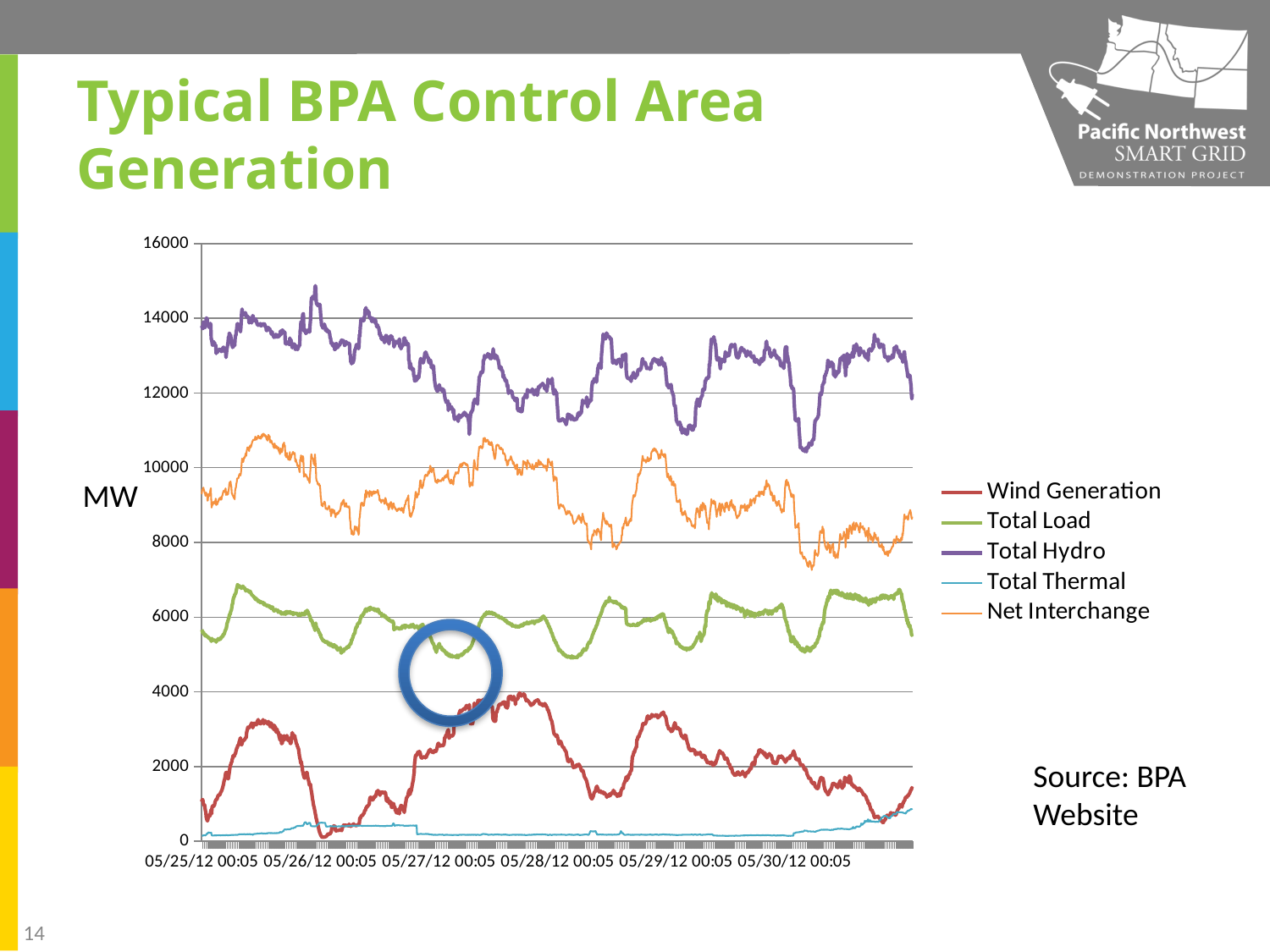
Which is larger around 05/28/12 00:05: Total Load or Wind Generation? Total Load What is the title of the chart on the slide? Typical BPA Control Area Generation Is the Total Hydro value at the start of the chart (05/25/12 00:05) greater or less than 12000? greater How many series does the legend list? 5 What is the highest value shown on the vertical axis of the chart? 16000 Is the Total Thermal value greater or less than 2000 throughout the chart? less Is the Net Interchange value at the start of the chart (05/25/12 00:05) greater or less than 8000? greater Which series stays highest on the chart throughout the period shown? Total Hydro What unit is labelled on the vertical axis of the chart? MW Which is larger at the start of the chart: Net Interchange or Total Load? Net Interchange What kind of chart is shown on the slide? line chart